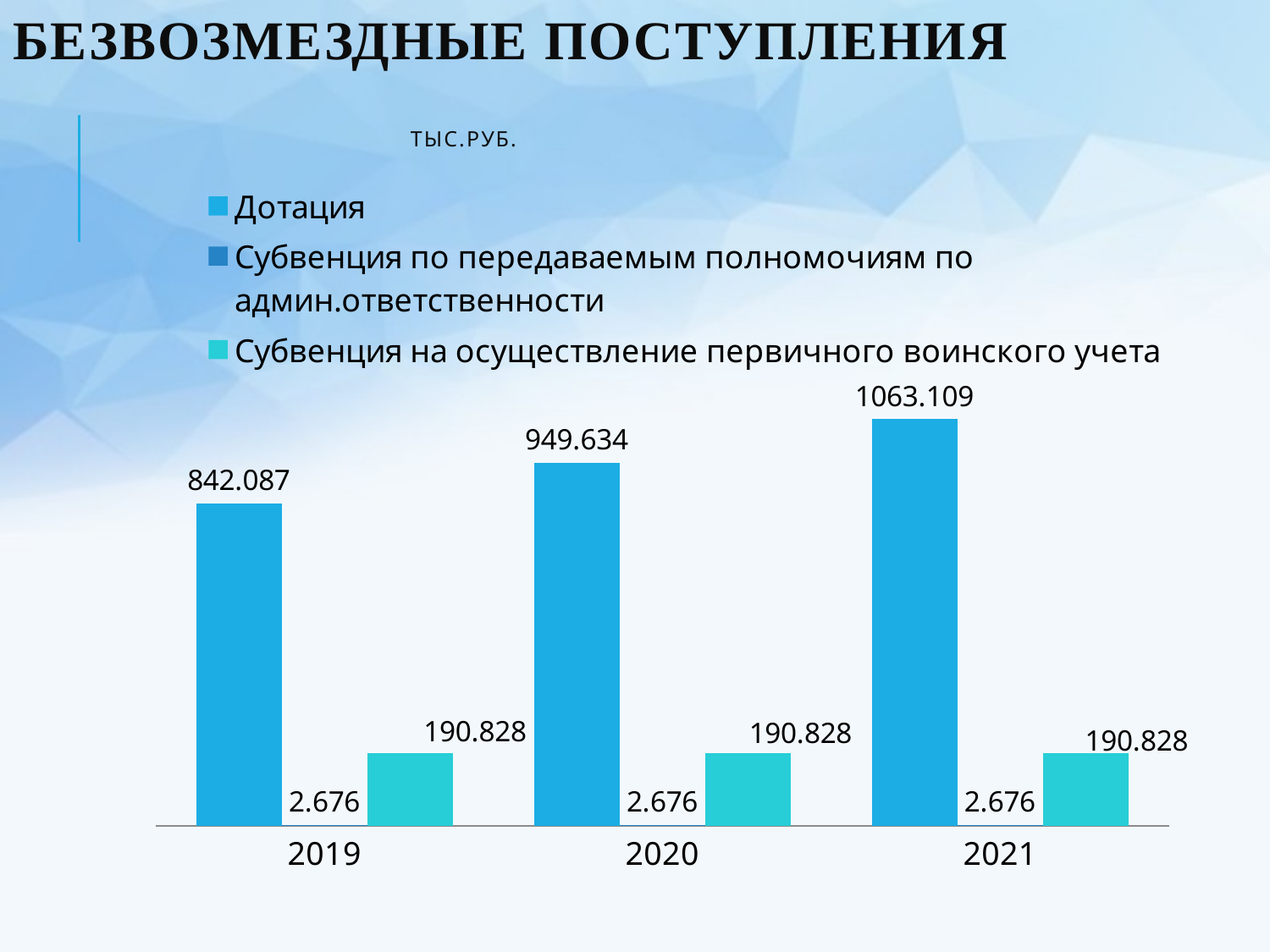
What is the value of Дотация in 2021? 1063.109 In which year is Дотация the lowest? 2019 What is the difference between Дотация in 2020 and in 2019? 107.547 What is the value of Субвенция на осуществление первичного воинского учета in 2020? 190.828 How many series does the legend list? 3 Which is larger in 2019: Дотация or Субвенция на осуществление первичного воинского учета? Дотация What is the value of Субвенция по передаваемым полномочиям по админ.ответственности in 2021? 2.676 What is the value of Дотация in 2019? 842.087 How many years are shown on the x axis? 3 Does Дотация rise or fall from 2019 to 2021? rise What is the difference between Дотация in 2021 and in 2020? 113.475 In which year is Дотация the highest? 2021